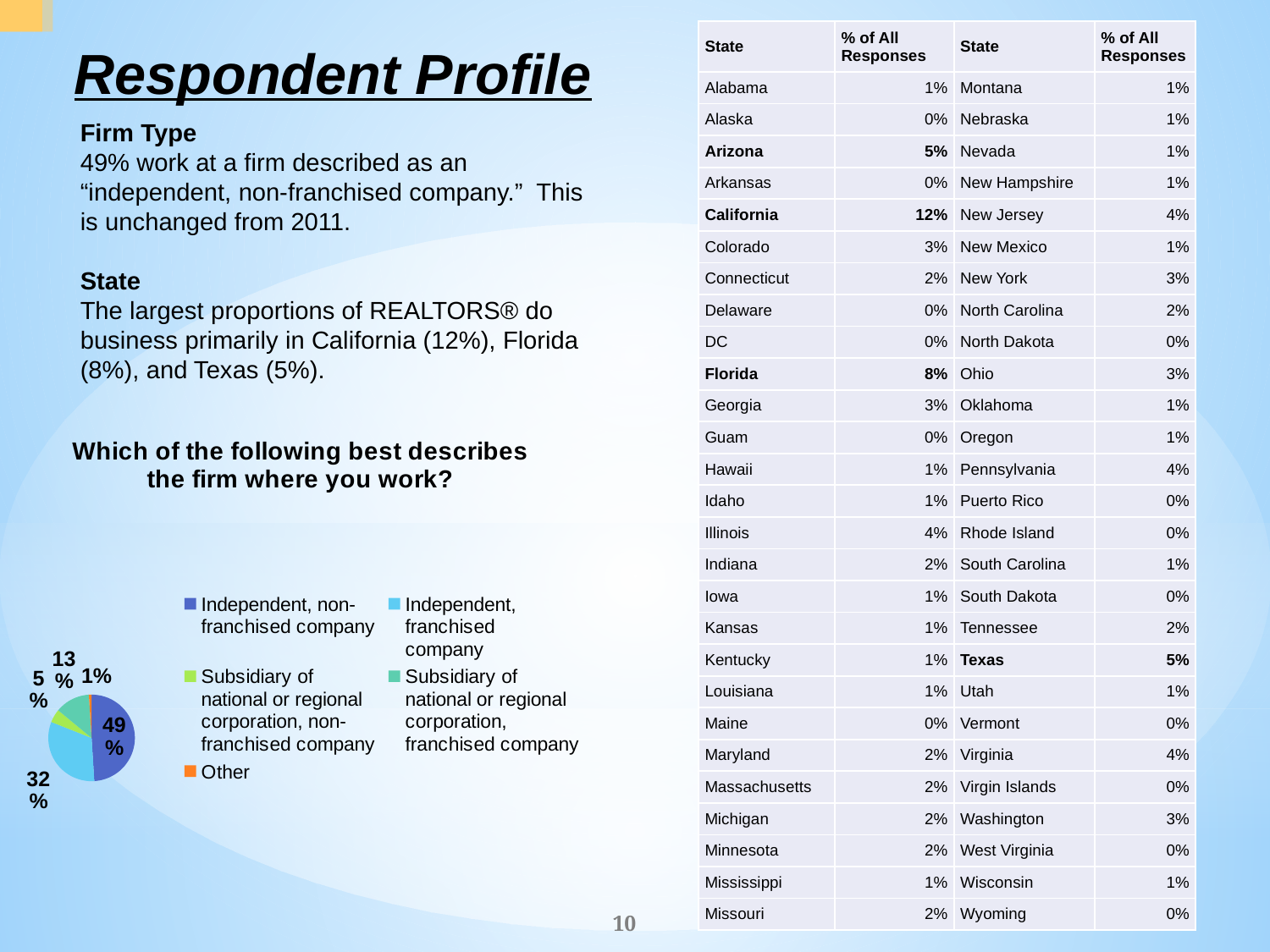
What kind of chart is shown on the slide? pie chart How many slices does the pie chart have? 5 What share of the pie is 'Subsidiary of national or regional corporation, franchised company'? 13% Which category has the smallest slice of the pie? Other What share of the pie is 'Independent, non-franchised company'? 49% What share of the pie is 'Other'? 1% How many entries does the pie chart's legend list? 5 What is the title of the pie chart? Which of the following best describes the firm where you work? What is the difference in percentage points between the 'Independent, non-franchised company' slice and the 'Independent, franchised company' slice? 17 Which category has the largest slice of the pie? Independent, non-franchised company